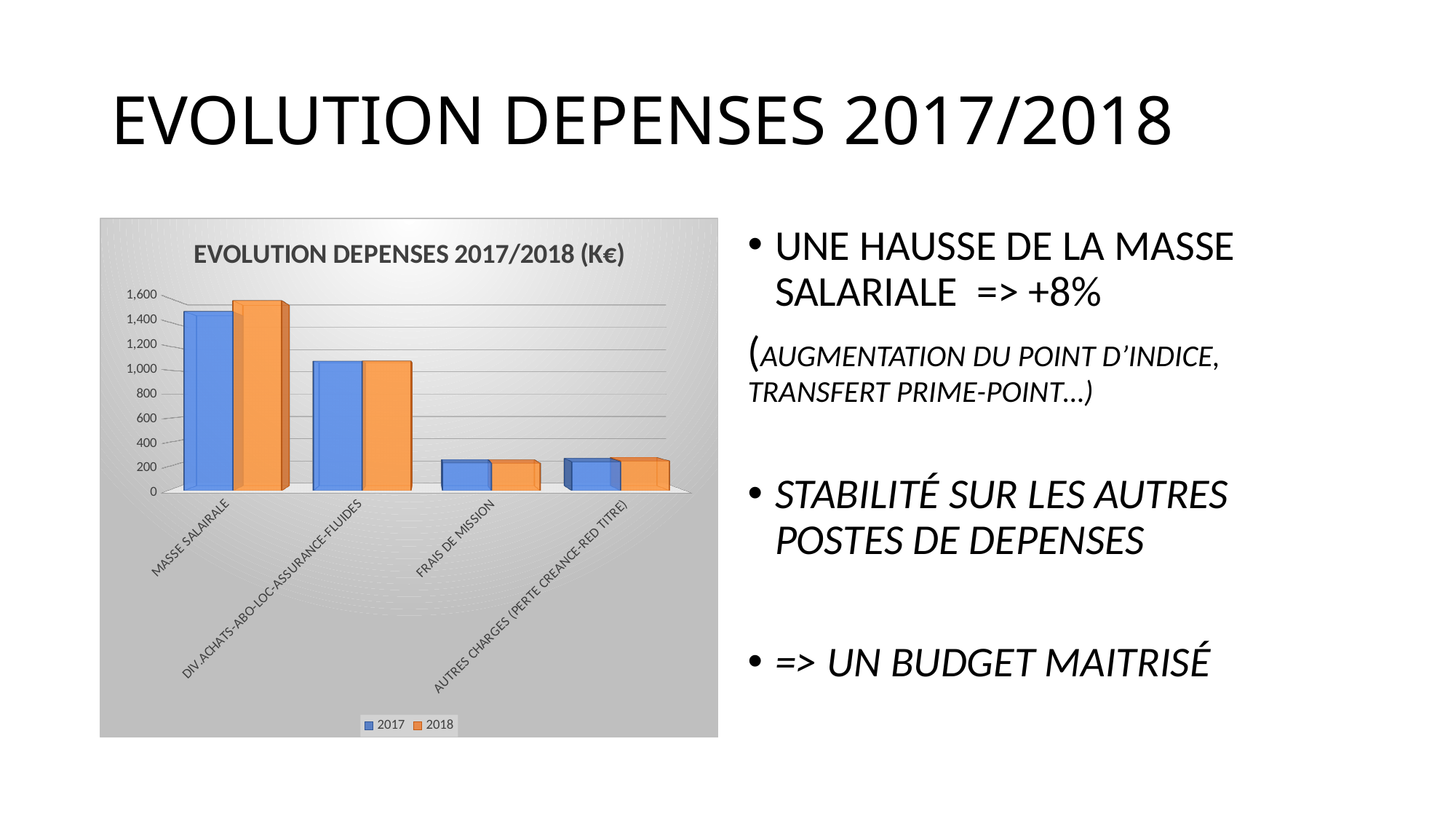
How many series does the chart legend list? 2 Is the 2018 value for FRAIS DE MISSION greater or less than 400? less Is the 2018 value for MASSE SALARIALE greater or less than 1,400? greater What type of chart is shown on the slide? Bar chart Which colour represents the 2018 series in the chart? Orange What is the title of the chart? EVOLUTION DEPENSES 2017/2018 (K€) For MASSE SALARIALE, which is larger: the 2017 value or the 2018 value? 2018 How many categories are shown on the x axis of the chart? 4 Is the 2017 value for DIV.ACHATS-ABO-LOC-ASSURANCE-FLUIDES greater or less than 1,200? less In 2017, which is larger: MASSE SALARIALE or DIV.ACHATS-ABO-LOC-ASSURANCE-FLUIDES? MASSE SALARIALE Which category has the highest value for 2018? MASSE SALARIALE